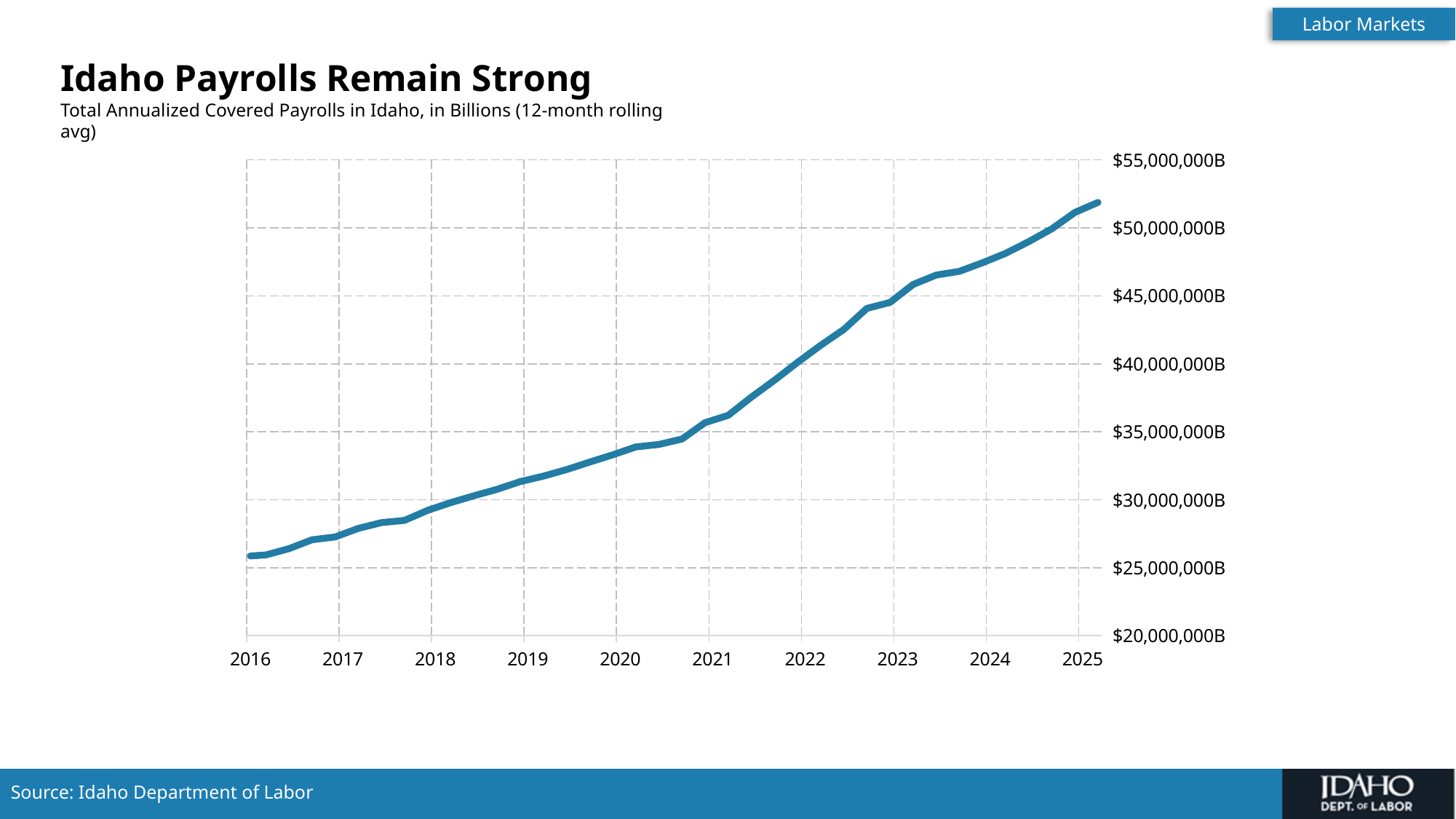
Do the payroll values rise or fall from 2016 to 2025? rise What kind of chart is shown on the slide? line chart Is the value for 2024 greater or less than $45,000,000B? greater Is the value for 2016 greater or less than $30,000,000B? less Is the value for 2019 greater or less than $35,000,000B? less What is the title of the chart? Idaho Payrolls Remain Strong Which year shown on the x axis has the lowest payroll value? 2016 Which is larger, the value for 2024 or the value for 2020? 2024 Which year shown on the x axis has the highest payroll value? 2025